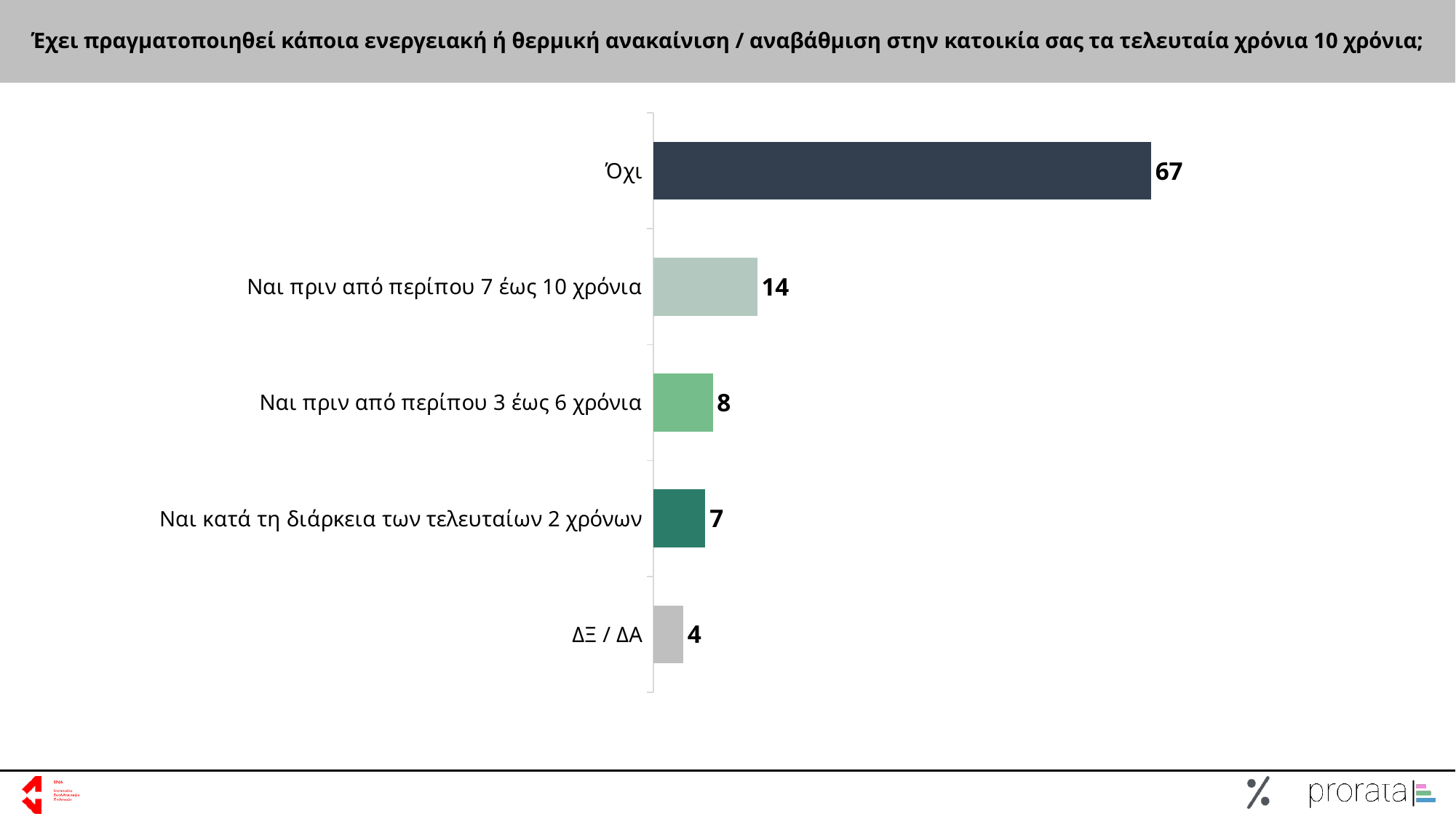
What kind of chart is shown on the slide? Bar chart How many categories are shown in the chart? 5 What colour is the bar for Όχι? Dark navy Which category has the lowest value? ΔΞ / ΔΑ What is the value for ΔΞ / ΔΑ? 4 What is the value for Ναι κατά τη διάρκεια των τελευταίων 2 χρόνων? 7 Which category has the highest value? Όχι What is the difference between the values for Όχι and Ναι πριν από περίπου 7 έως 10 χρόνια? 53 What is the value for Ναι πριν από περίπου 7 έως 10 χρόνια? 14 What is the value for Όχι? 67 What is the value for Ναι πριν από περίπου 3 έως 6 χρόνια? 8 Which is larger: the value for Ναι πριν από περίπου 3 έως 6 χρόνια or the value for ΔΞ / ΔΑ? Ναι πριν από περίπου 3 έως 6 χρόνια